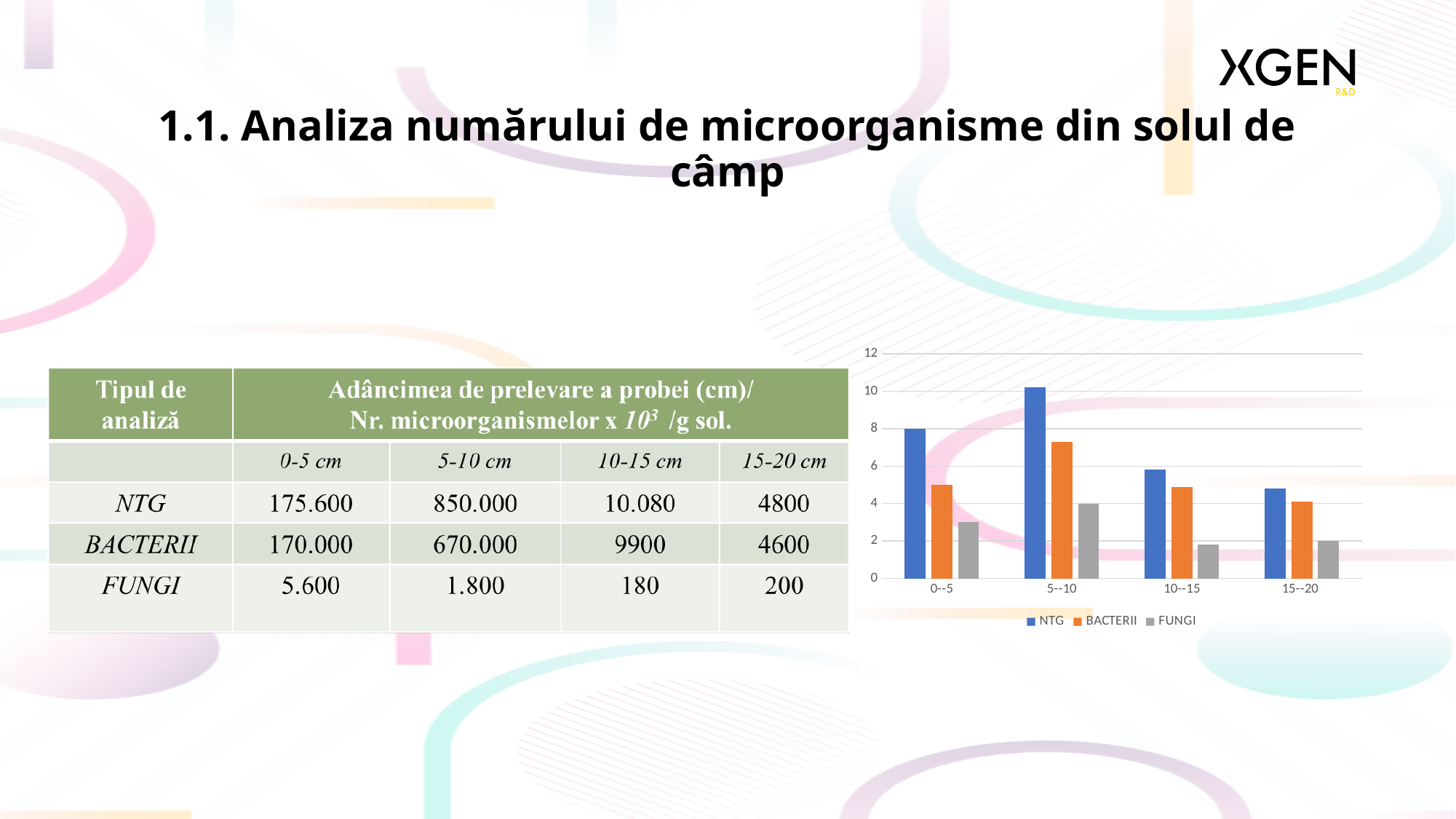
In the bar chart, which category has the highest NTG bar? 5--10 How many series does the legend of the bar chart list? 3 In the bar chart, which category has the lowest FUNGI bar? 10--15 In the bar chart, is the FUNGI value for 0--5 greater or less than 4? less In the bar chart, which is larger for the 5--10 category: NTG or BACTERII? NTG In the bar chart, do the NTG values rise or fall from 5--10 to 15--20? fall In the bar chart, is the BACTERII value for 15--20 greater or less than 6? less In the bar chart, which is larger for the 10--15 category: BACTERII or FUNGI? BACTERII In the bar chart, which series is shown in orange? BACTERII How many categories are shown on the x axis of the bar chart? 4 What kind of chart is shown on the right of the slide? bar chart